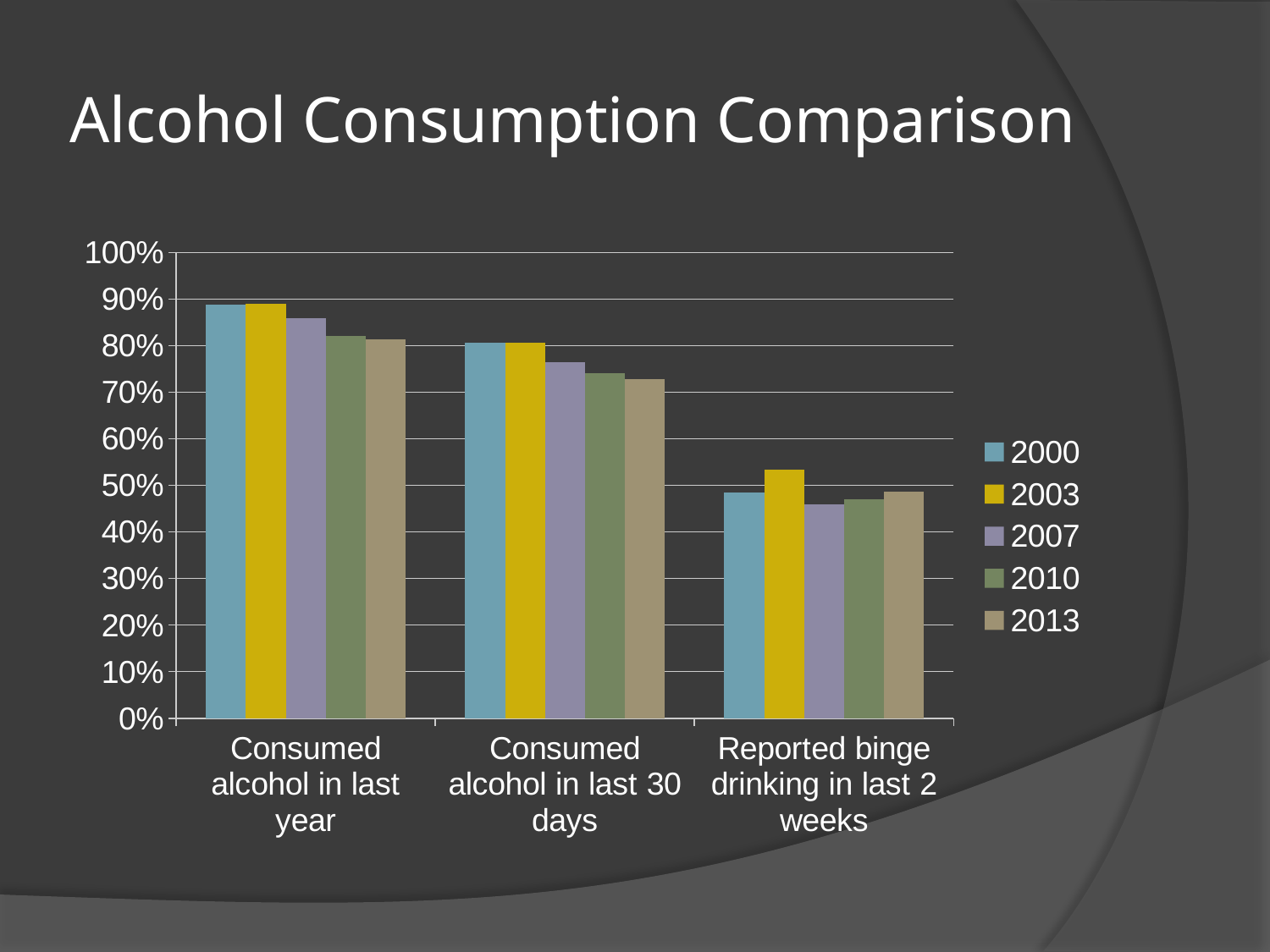
How many series does the legend list? 5 What kind of chart is shown on the slide? Bar chart What is the title of the chart? Alcohol Consumption Comparison Is the value for 2003 in the 'Reported binge drinking in last 2 weeks' category greater or less than 50%? greater Which year has the highest value in the 'Reported binge drinking in last 2 weeks' category? 2003 Is the value for 2007 in the 'Reported binge drinking in last 2 weeks' category greater or less than 50%? less For the 2013 series, which category has the highest value? Consumed alcohol in last year In the 'Consumed alcohol in last 30 days' category, which is larger: the value for 2007 or the value for 2010? 2007 Is the value for 2007 in the 'Consumed alcohol in last year' category greater or less than 80%? greater How many categories are shown on the x axis? 3 For the 2000 series, which category has the lowest value? Reported binge drinking in last 2 weeks